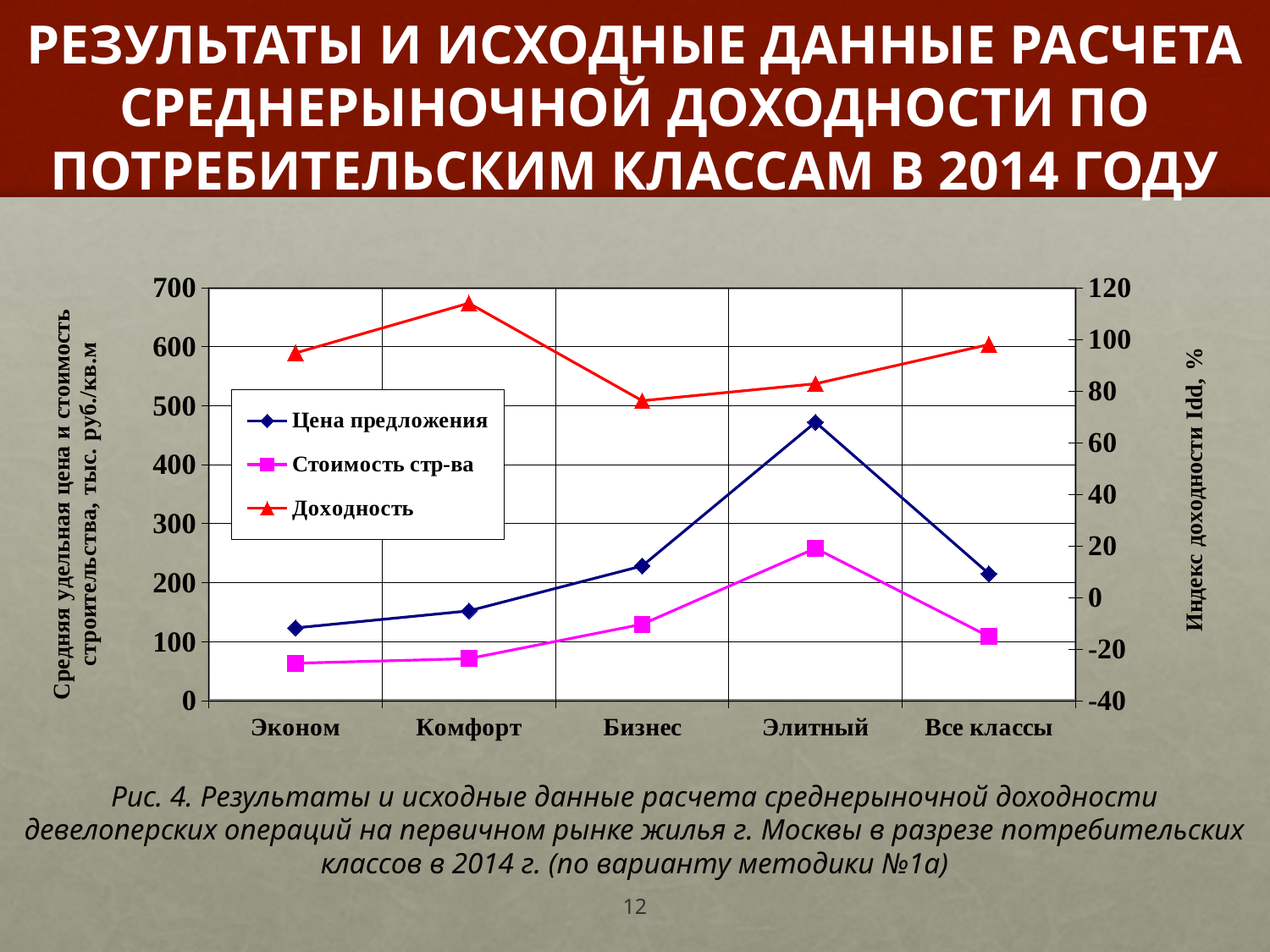
Which series is plotted with red triangle markers? Доходность Is the value for Цена предложения in the Элитный category greater or less than 400? greater Which category has the lowest value for Цена предложения? Эконом Is the value for Стоимость стр-ва in the Эконом category greater or less than 100? less Which category has the lowest value for Доходность? Бизнес Which category has the highest value for Цена предложения? Элитный How many categories are shown on the x axis? 5 Which category has the highest value for Стоимость стр-ва? Элитный Which is larger: Цена предложения for Бизнес or Цена предложения for Комфорт? Бизнес How many series does the legend list? 3 What kind of chart is shown on the slide? line chart Which category has the highest value for Доходность? Комфорт